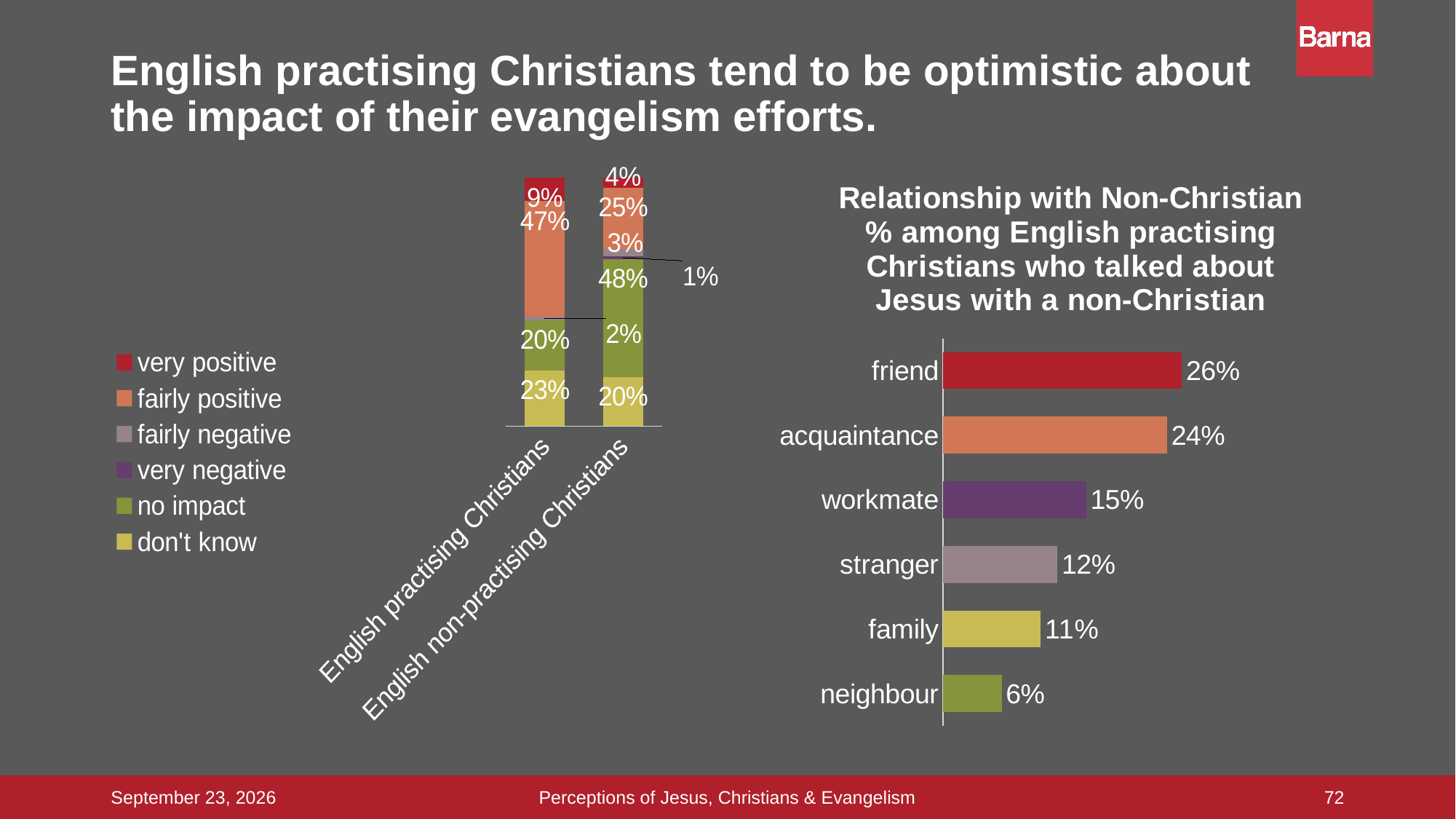
In the chart titled 'Relationship with Non-Christian', which relationship has the lowest percentage? neighbour In the stacked bar chart on the left, what is the 'no impact' value for English non-practising Christians? 48% In the chart titled 'Relationship with Non-Christian', which relationship has the highest percentage? friend In the stacked bar chart on the left, what is the 'very positive' value for English non-practising Christians? 4% In the chart titled 'Relationship with Non-Christian', what percentage is shown for friend? 26% In the chart titled 'Relationship with Non-Christian', what percentage is shown for neighbour? 6% In the chart titled 'Relationship with Non-Christian', what is the difference between the percentages for workmate and stranger? 3% In the stacked bar chart on the left, how many series does the legend list? 6 In the chart titled 'Relationship with Non-Christian', what kind of chart is used? bar chart In the stacked bar chart on the left, which group has the larger 'fairly positive' value, English practising Christians or English non-practising Christians? English practising Christians In the stacked bar chart on the left, what is the 'fairly positive' value for English practising Christians? 47% In the chart titled 'Relationship with Non-Christian', how many relationship categories are shown? 6